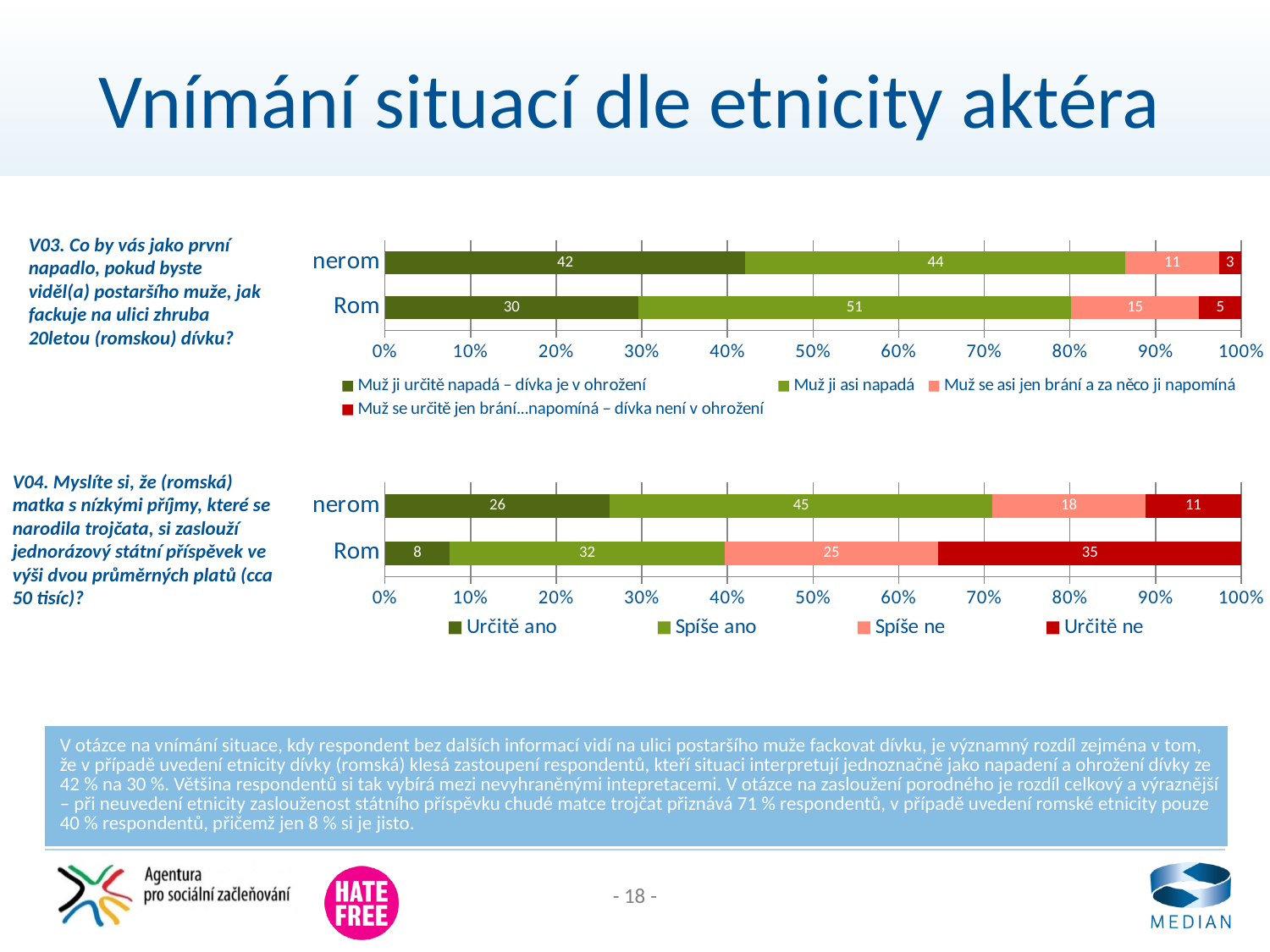
In the top chart (V03), what is the total of the 'Rom' stacked bar? 101 What type of chart is the bottom chart (V04)? Stacked bar chart In the bottom chart (V04), which bar has the larger 'Určitě ano' value, 'nerom' or 'Rom'? nerom In the bottom chart (V04), what is the difference between the 'Určitě ne' values for 'Rom' and 'nerom'? 24 In the top chart (V03), what is the value of 'Muž ji určitě napadá – dívka je v ohrožení' for the 'nerom' bar? 42 In the bottom chart (V04), how many categories are shown on the vertical axis? 2 In the bottom chart (V04), what is the last legend entry? Určitě ne In the top chart (V03), what is the value of 'Muž ji asi napadá' for the 'Rom' bar? 51 In the bottom chart (V04), what is the value of 'Určitě ne' for the 'Rom' bar? 35 In the bottom chart (V04), what is the value of 'Spíše ano' for the 'nerom' bar? 45 In the top chart (V03), what is the difference between the 'Muž ji určitě napadá – dívka je v ohrožení' values for 'nerom' and 'Rom'? 12 In the top chart (V03), how many series does the legend list? 4